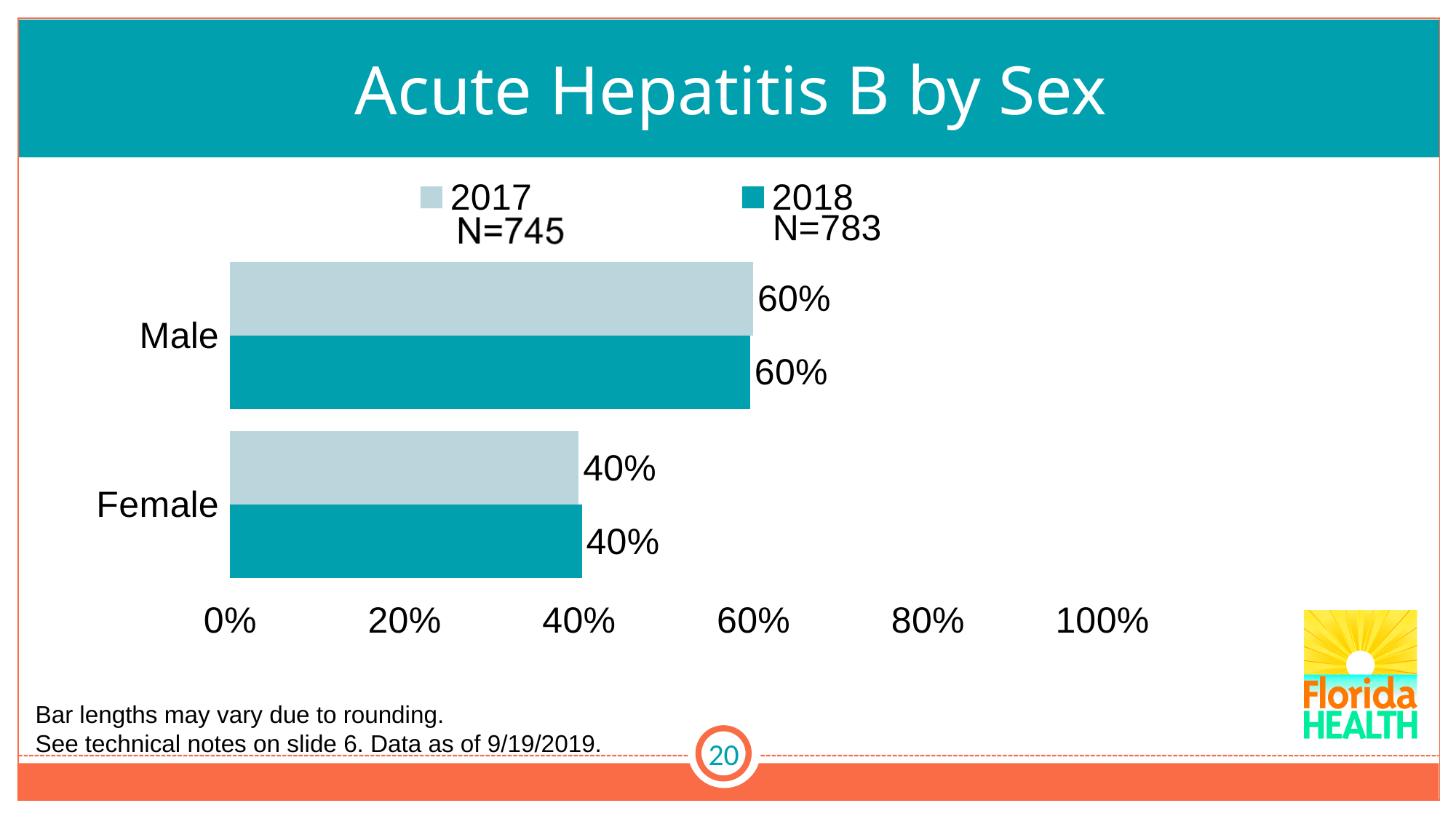
What is the value for Female in 2017? 40% Which is larger in 2017, the value for Male or the value for Female? Male What is the value for Female in 2018? 40% What is the N value shown in the legend for 2018? N=783 How many series does the legend list? 2 What is the value for Male in 2017? 60% What is the difference between the Male and Female values in 2018? 20% How many categories are shown on the chart? 2 What kind of chart is shown on the slide? Bar chart Which category has the lowest value in 2017? Female Which category has the highest value in 2018? Male What is the value for Male in 2018? 60%